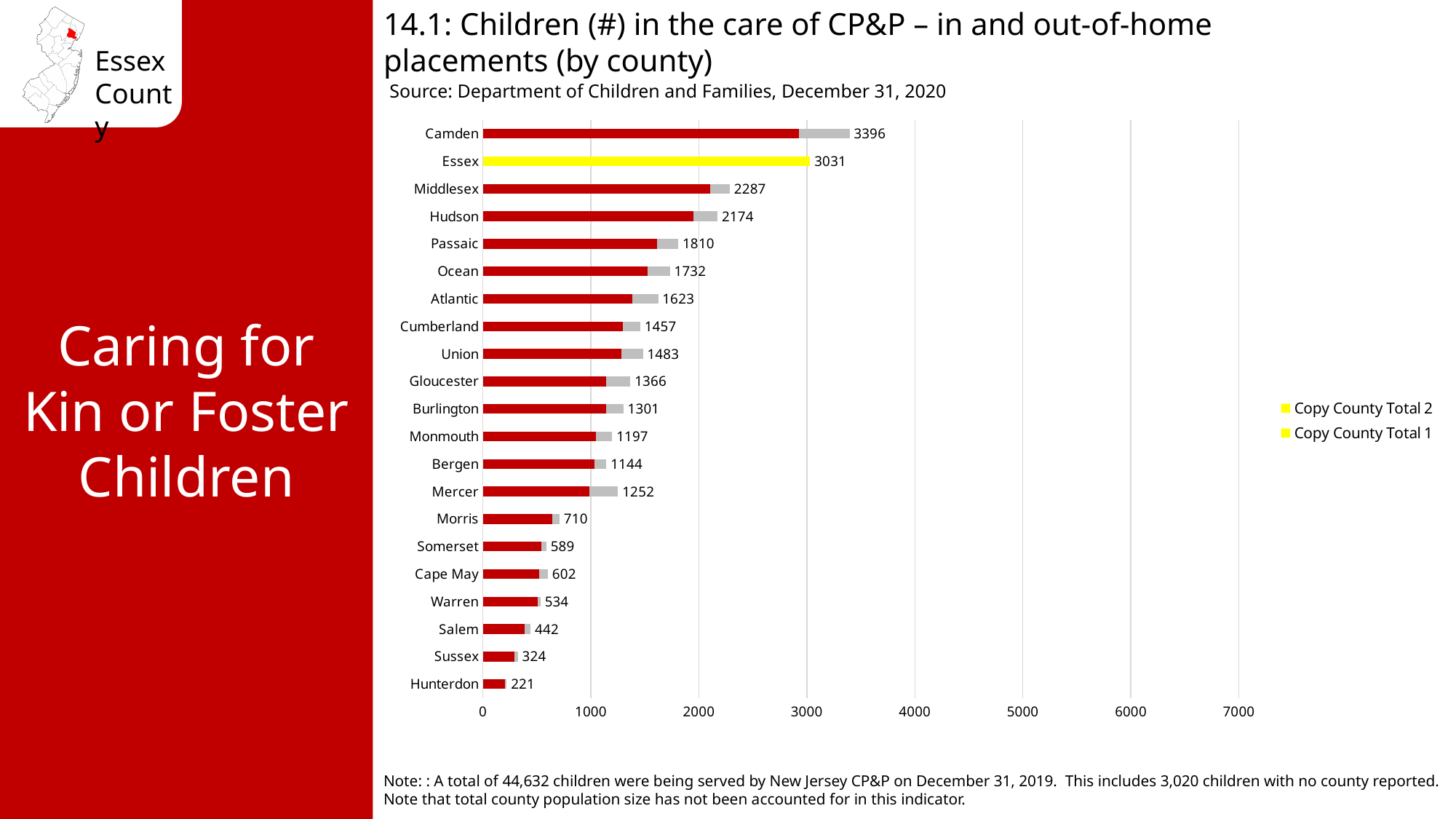
Which county has a larger total, Middlesex or Hudson? Middlesex What is the total number of children in the care of CP&P for Mercer? 1252 What kind of chart is shown on the slide? Bar chart What is the total number of children in the care of CP&P for Camden? 3396 What is the total number of children in the care of CP&P for Hudson? 2174 Is the total for Passaic greater or less than 2000? less What is the total number of children in the care of CP&P for Essex? 3031 How many counties are shown on the chart? 21 What is the difference between the totals for Camden and Essex? 365 How many series does the legend list? 2 Which county has the lowest total number of children in the care of CP&P? Hunterdon Which county has the highest total number of children in the care of CP&P? Camden